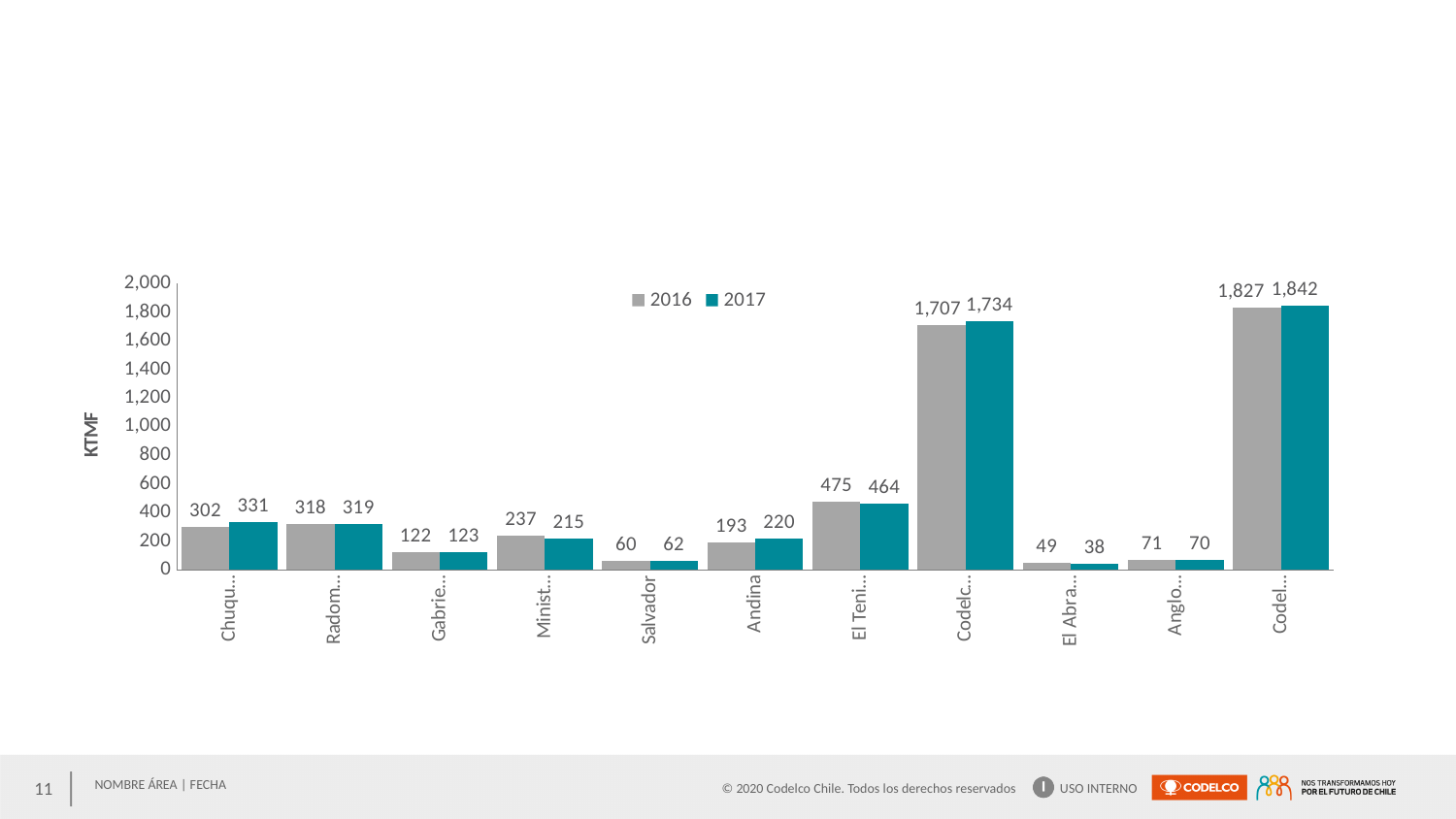
What is the 2017 value for Andina? 220 What is the title of the vertical axis? KTMF By how much did Andina's value increase from 2016 to 2017? 27 What is the highest value labelled on the chart? 1,842 What kind of chart is shown on the slide? Bar chart What is the 2016 value for Andina? 193 For Salvador, which year has the larger value, 2016 or 2017? 2017 What is the 2016 value for Salvador? 60 What is the difference between the 2017 and 2016 values for Salvador? 2 How many series does the legend list? 2 How many categories are shown on the x axis? 11 What is the lowest 2017 value labelled on the chart? 38